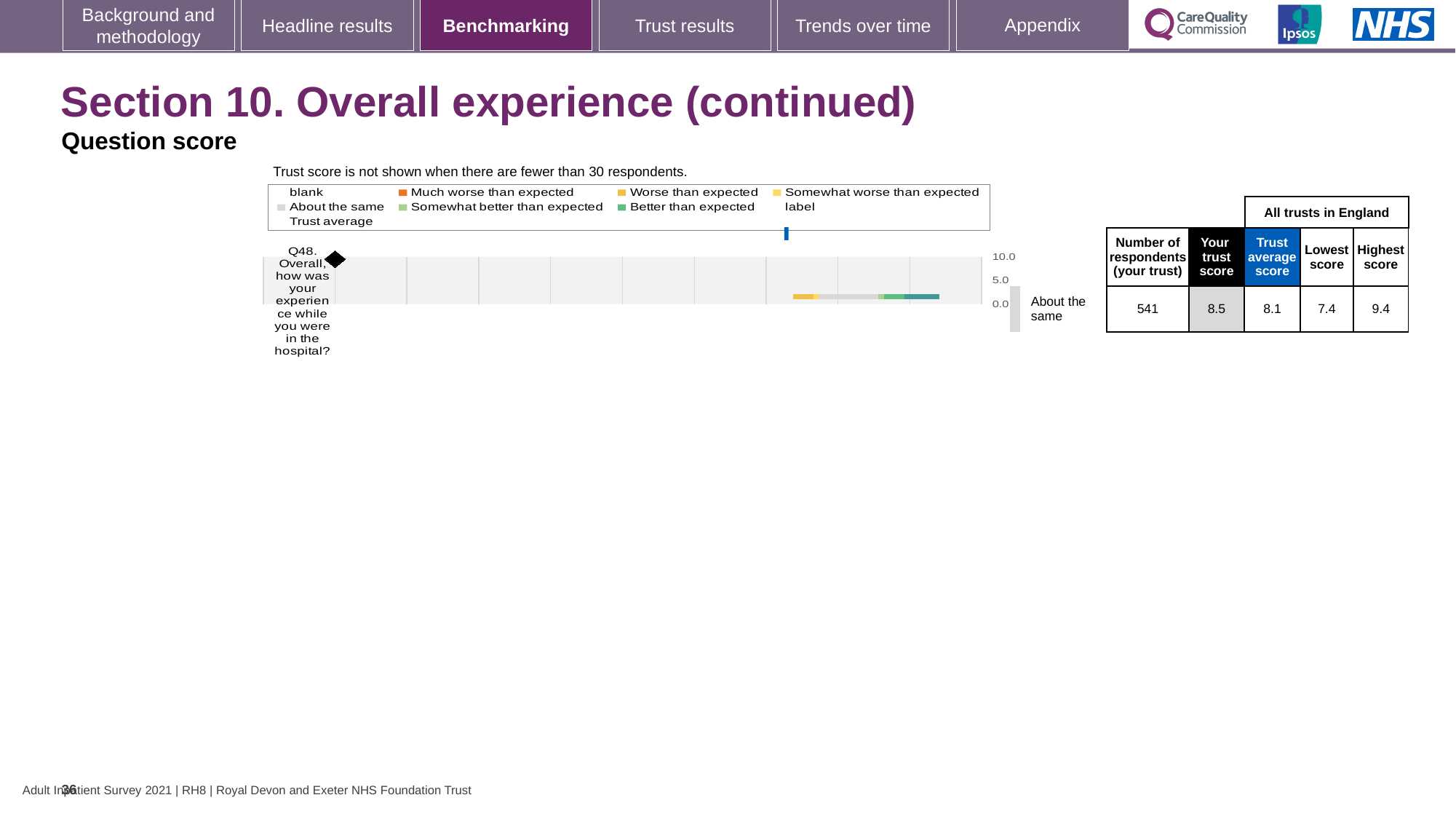
What is the lowest score among all trusts in England for Q48? 7.4 What colour does the legend use for 'Much worse than expected'? Orange By how much does your trust score for Q48 exceed the trust average score? 0.4 What is the 'Your trust score' value for Q48 (Overall, how was your experience while you were in the hospital?)? 8.5 How many respondents from your trust answered Q48? 541 Which is larger for Q48: your trust score or the trust average score? Your trust score What kind of chart is used to show the Q48 benchmarking result? Bar chart What is the highest score among all trusts in England for Q48? 9.4 How many questions are plotted on the chart? 1 What is the difference between the highest and lowest scores for Q48 across all trusts in England? 2.0 Which benchmarking category is your trust's Q48 score placed in? About the same What is the trust average score for Q48 across all trusts in England? 8.1